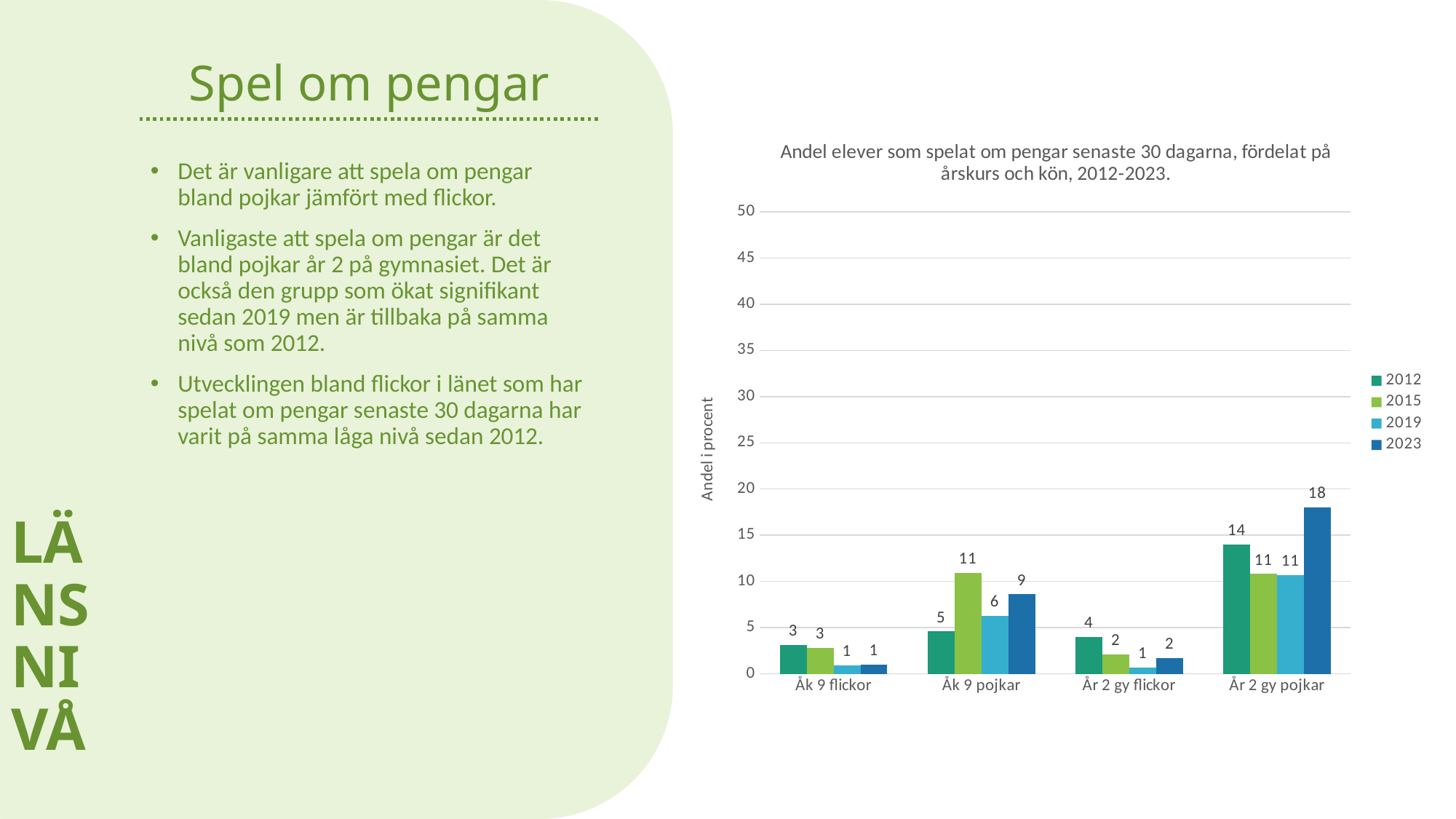
Which is larger for 'Åk 9 pojkar': the 2015 value or the 2023 value? 2015 What is the value for 2019 in the 'Åk 9 flickor' group? 1 What is the value for 2023 in the 'År 2 gy pojkar' group? 18 What is the value for 2012 in the 'År 2 gy flickor' group? 4 Is the value for 2023 in the 'År 2 gy pojkar' group greater or less than 15? greater Which category has the highest value for the 2023 series? År 2 gy pojkar How many series does the legend list? 4 What kind of chart is shown on the slide? Bar chart How many categories are shown on the x axis? 4 What is the difference between the 2023 and 2012 values for 'År 2 gy pojkar'? 4 Which category has the lowest value for the 2012 series? Åk 9 flickor What is the value for 2015 in the 'Åk 9 pojkar' group? 11